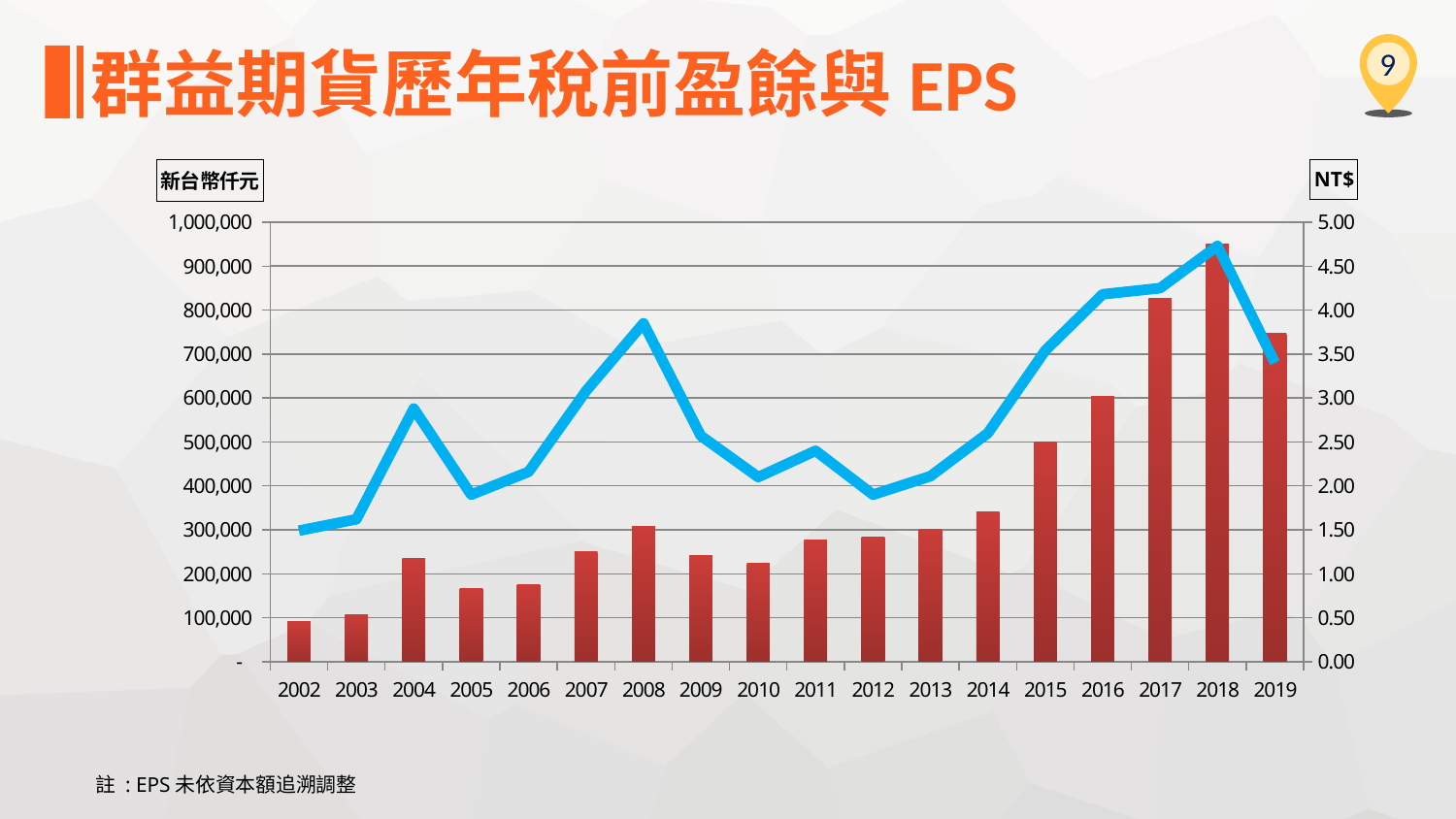
Is the bar value for 2017 greater or less than 800,000? greater How many years are shown on the x axis of the chart? 18 Which year has the shortest bar (lowest pre-tax earnings)? 2002 Do the bars rise or fall from 2014 to 2018? rise Which year has the tallest bar (highest pre-tax earnings)? 2018 Which year has the larger bar, 2017 or 2019? 2017 What is the title of the chart on the slide? 群益期貨歷年稅前盈餘與 EPS Is the EPS line value for 2008 greater or less than 3.50? greater Is the EPS line value for 2018 greater or less than 4.50? greater What unit label is shown above the right-hand axis of the chart? NT$ What kind of chart is shown on the slide? Combined bar and line chart